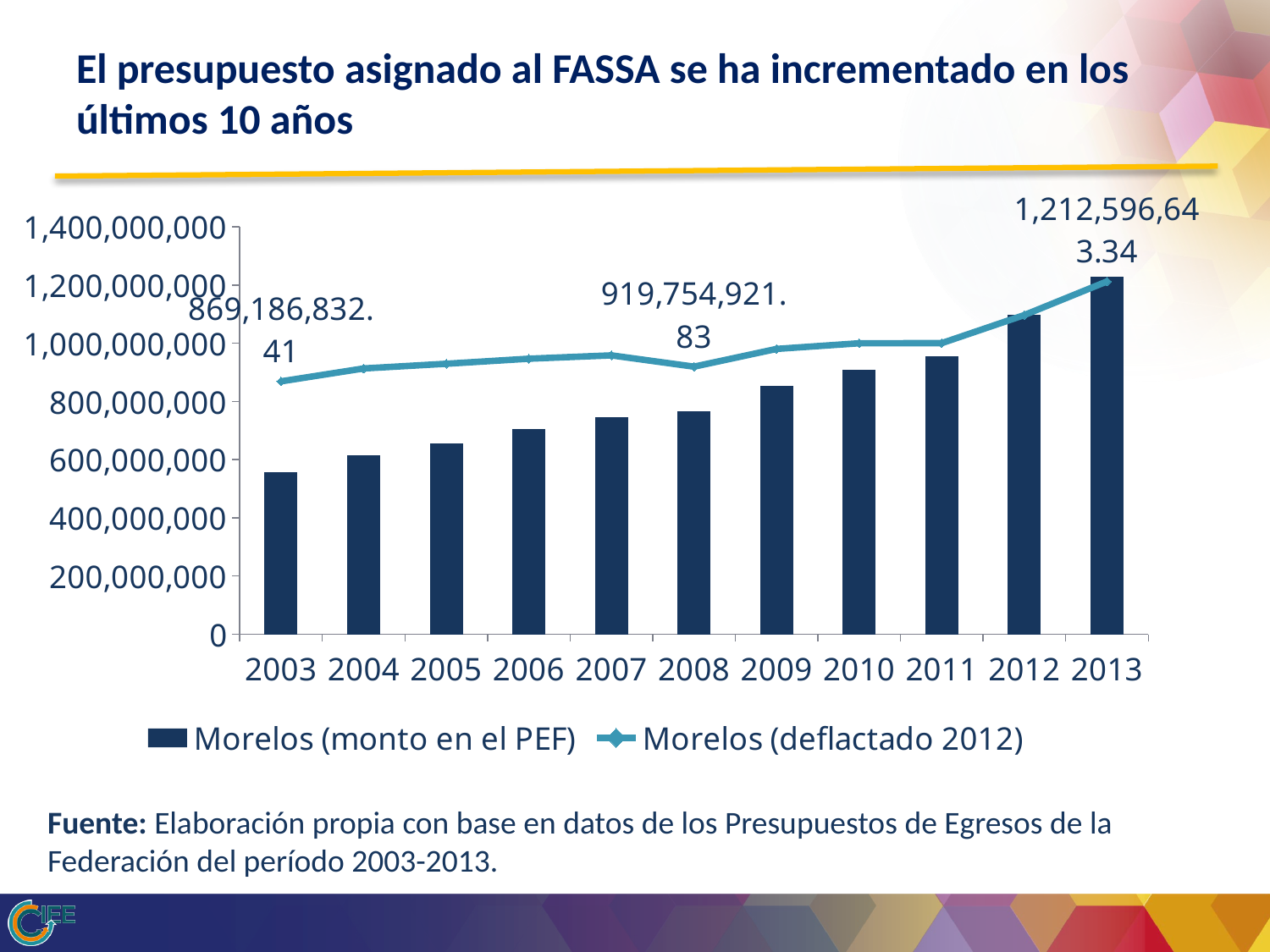
Which year has the lowest bar for Morelos (monto en el PEF)? 2003 Which is larger, the Morelos (monto en el PEF) bar for 2010 or for 2005? 2010 Is the Morelos (monto en el PEF) bar for 2012 greater or less than 1,000,000,000? greater How many years are shown on the x axis of the chart? 11 What is the overall trend of the Morelos (monto en el PEF) bars from 2003 to 2013? Rising What is the value of the Morelos (deflactado 2012) series in 2008? 919,754,921.83 Which year has the highest bar for Morelos (monto en el PEF)? 2013 How many series does the chart legend list? 2 What is the value of the Morelos (deflactado 2012) series in 2013? 1,212,596,643.34 Is the Morelos (monto en el PEF) bar for 2003 greater or less than 600,000,000? less What is the value of the Morelos (deflactado 2012) series in 2003? 869,186,832.41 By how much did the Morelos (deflactado 2012) value increase from 2003 to 2013? 343,409,810.93